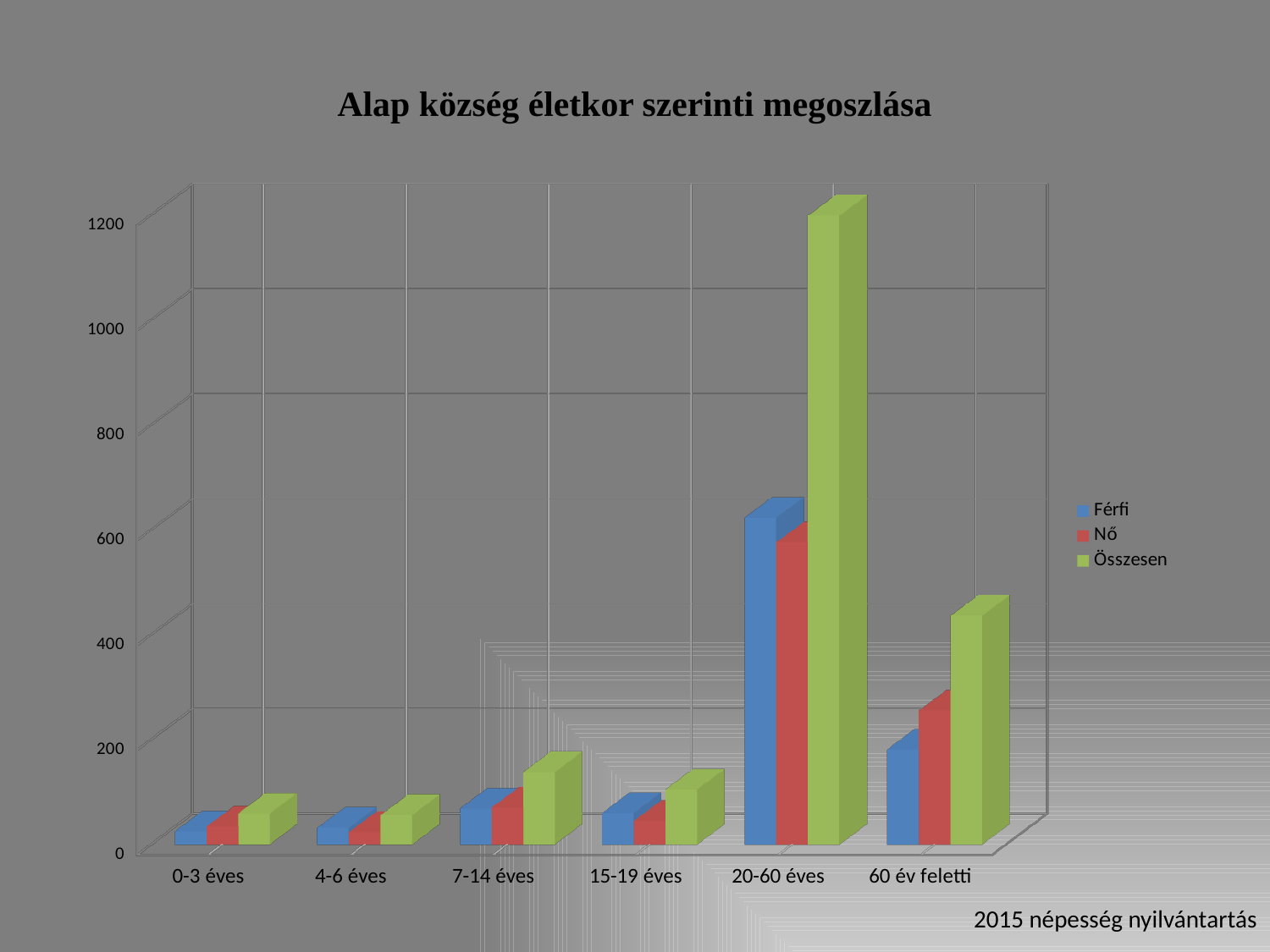
Is the Összesen value for 7-14 éves greater or less than 200? less Is the Összesen value for 60 év feletti greater or less than 200? greater Is the Összesen value for 20-60 éves greater or less than 1000? greater How many age categories are shown on the x axis? 6 How many series does the legend list? 3 Which is larger, the Összesen value for 20-60 éves or for 60 év feletti? 20-60 éves What type of chart is shown on the slide? bar chart Which series are listed in the legend? Férfi, Nő, Összesen Which age category has the highest Összesen value? 20-60 éves What is the title of the chart? Alap község életkor szerinti megoszlása